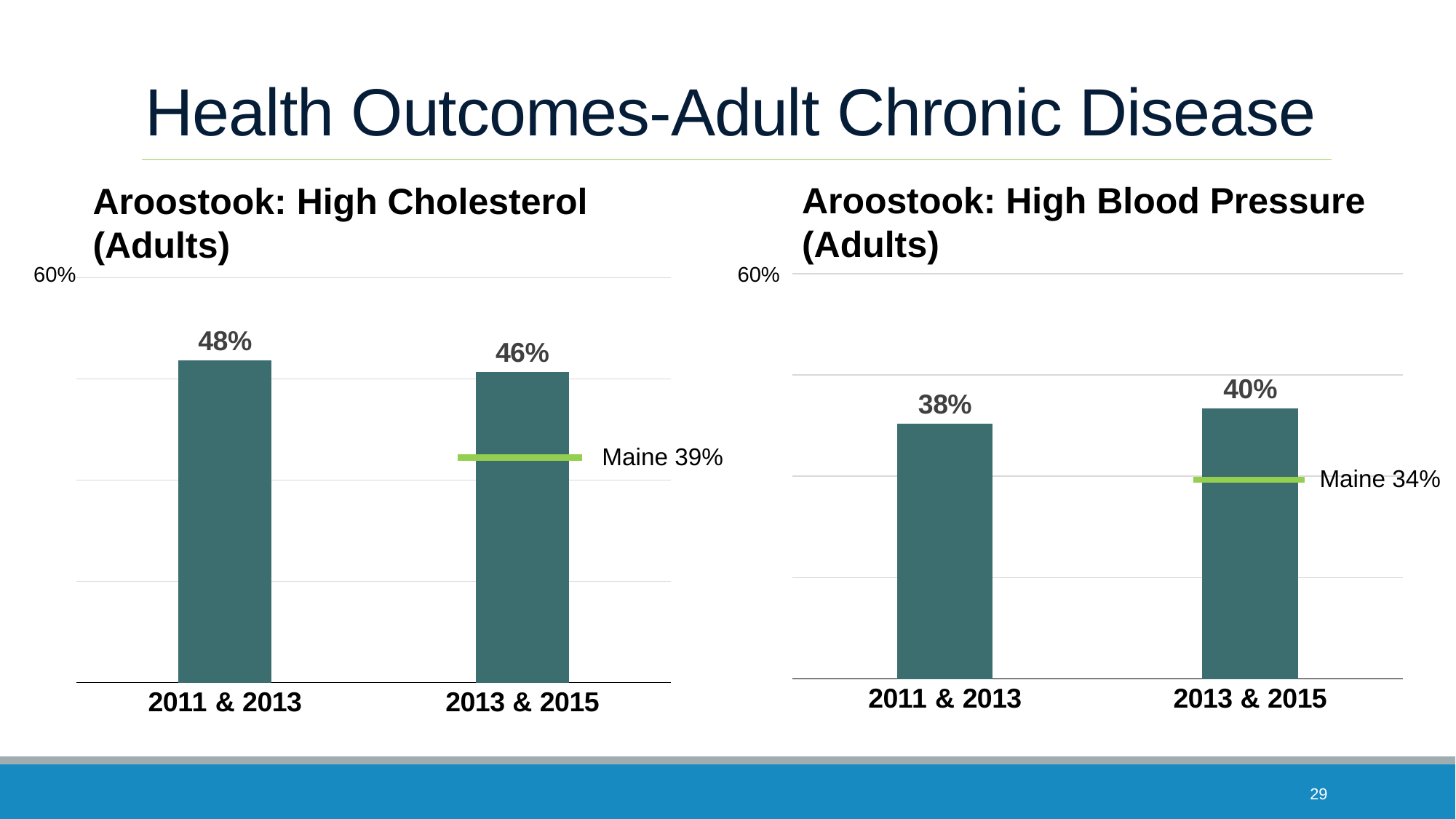
In the 'Aroostook: High Blood Pressure (Adults)' chart, do the values rise or fall from 2011 & 2013 to 2013 & 2015? rise In the 'Aroostook: High Blood Pressure (Adults)' chart, what is the value for 2013 & 2015? 40% In the 'Aroostook: High Cholesterol (Adults)' chart, what is the value for 2011 & 2013? 48% What kind of chart is the 'Aroostook: High Cholesterol (Adults)' chart? bar chart In the 'Aroostook: High Cholesterol (Adults)' chart, what is the Maine value shown by the green reference line? 39% In the 'Aroostook: High Blood Pressure (Adults)' chart, what is the value for 2011 & 2013? 38% In the 'Aroostook: High Cholesterol (Adults)' chart, what is the difference between the 2011 & 2013 value and the 2013 & 2015 value? 2% In the 'Aroostook: High Blood Pressure (Adults)' chart, how much higher is the 2013 & 2015 Aroostook value than the Maine value? 6% In the 'Aroostook: High Blood Pressure (Adults)' chart, which period has the lower value? 2011 & 2013 In the 'Aroostook: High Cholesterol (Adults)' chart, which period has the higher value? 2011 & 2013 In the 'Aroostook: High Blood Pressure (Adults)' chart, what is the Maine value shown by the green reference line? 34% In the 'Aroostook: High Cholesterol (Adults)' chart, what is the value for 2013 & 2015? 46%